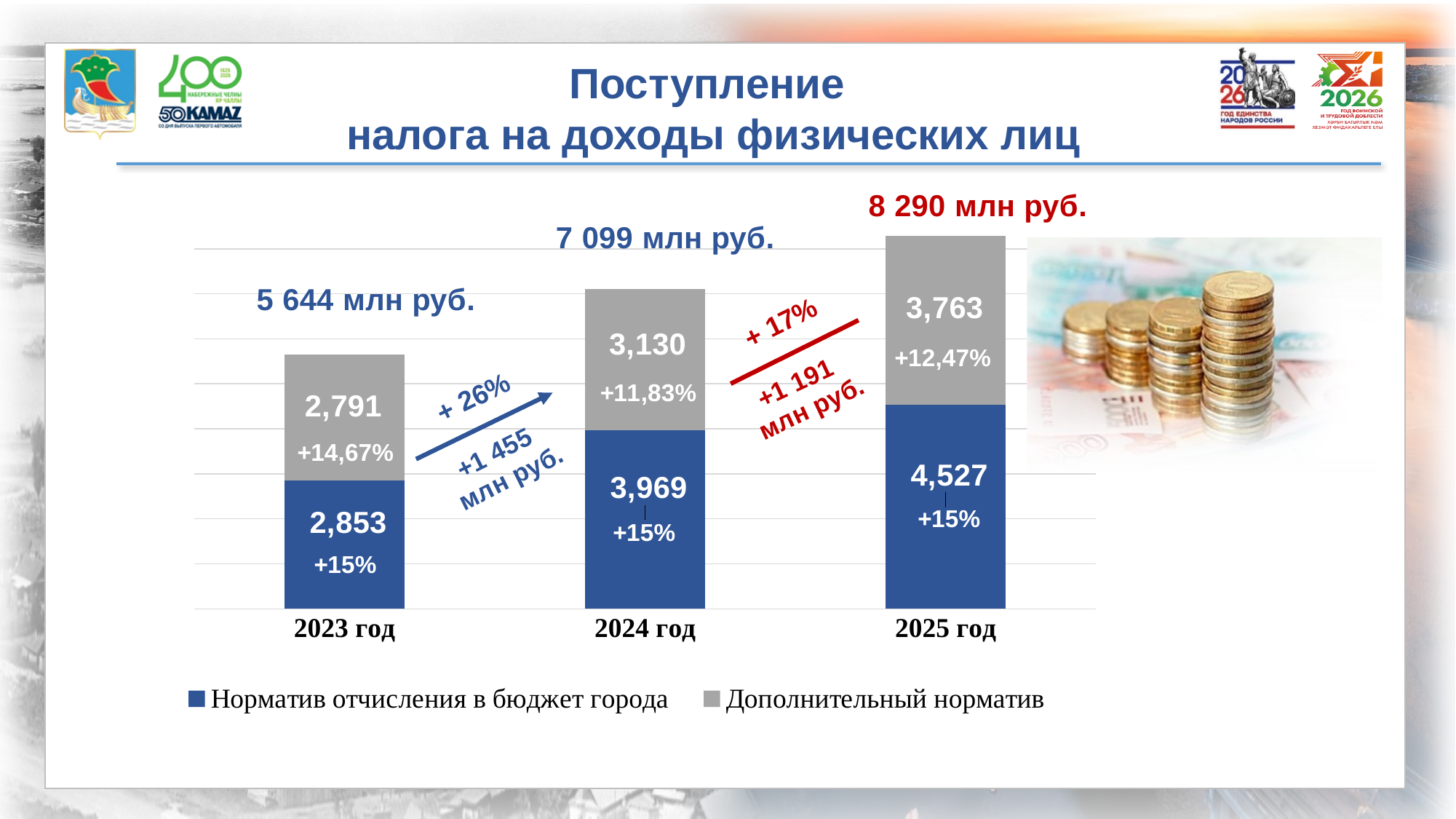
Which is larger in 2024 год: 'Норматив отчисления в бюджет города' or 'Дополнительный норматив'? Норматив отчисления в бюджет города What is the total shown above the stacked bar for 2023 год? 5 644 млн руб. How many years (categories) are shown on the x axis? 3 How many series does the legend list? 2 What is the value of the 'Норматив отчисления в бюджет города' series for 2023 год? 2,853 What is the total shown above the stacked bar for 2025 год? 8 290 млн руб. Do the total values rise or fall from 2023 год to 2025 год? rise What is the value of the 'Дополнительный норматив' series for 2024 год? 3,130 Which year has the highest value for the 'Дополнительный норматив' series? 2025 год What is the difference between the 'Норматив отчисления в бюджет города' values for 2024 год and 2023 год? 1,116 Which year has the lowest value for the 'Норматив отчисления в бюджет города' series? 2023 год What is the value of the 'Норматив отчисления в бюджет города' series for 2025 год? 4,527